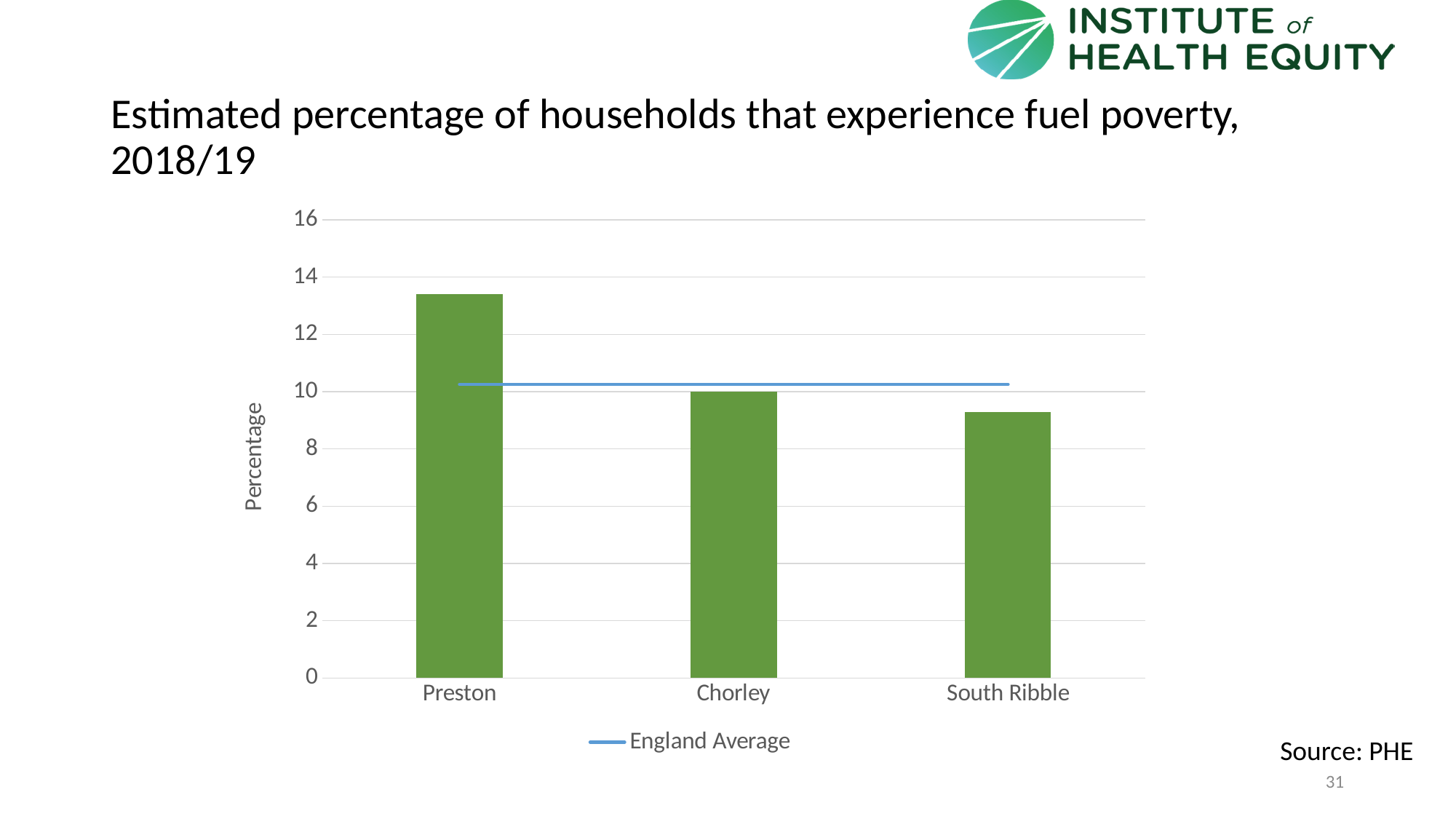
Is the value for Preston greater or less than 14? less Which is larger, the value for Preston or the value for Chorley? Preston Is the value for Preston greater or less than 12? greater Is the value for Chorley greater or less than 12? less What kind of chart is shown on the slide? bar chart Do the bar values rise or fall from left to right across the x axis? fall How many entries does the chart legend list? 1 Which area has the lowest estimated percentage of households in fuel poverty? South Ribble How many local areas are shown on the x axis of the chart? 3 Which area has the highest estimated percentage of households in fuel poverty? Preston What is the label on the vertical axis of the chart? Percentage